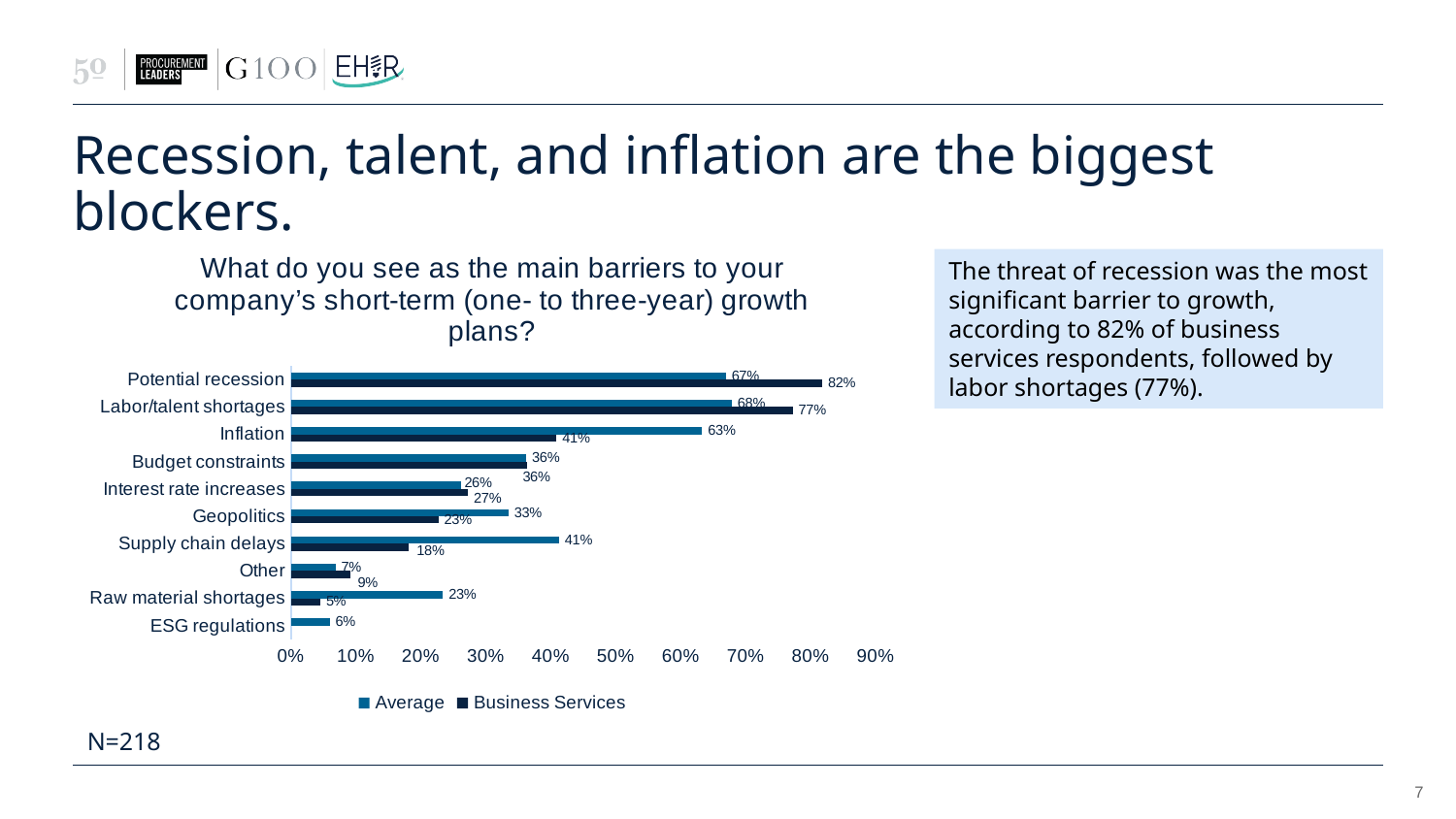
What is the Average value for Inflation? 63% What is the difference between the Business Services and Average values for Potential recession? 15 percentage points What is the difference between the Business Services and Average values for Labor/talent shortages? 9 percentage points What kind of chart is shown on the slide? Bar chart Which category has the highest Business Services value? Potential recession For Supply chain delays, which is larger: the Average value or the Business Services value? Average What is the Business Services value for Potential recession? 82% What is the Business Services value for Supply chain delays? 18% How many categories are shown on the chart? 10 How many series does the legend list? 2 Which category has the lowest Average value? ESG regulations What are the two series named in the legend? Average and Business Services